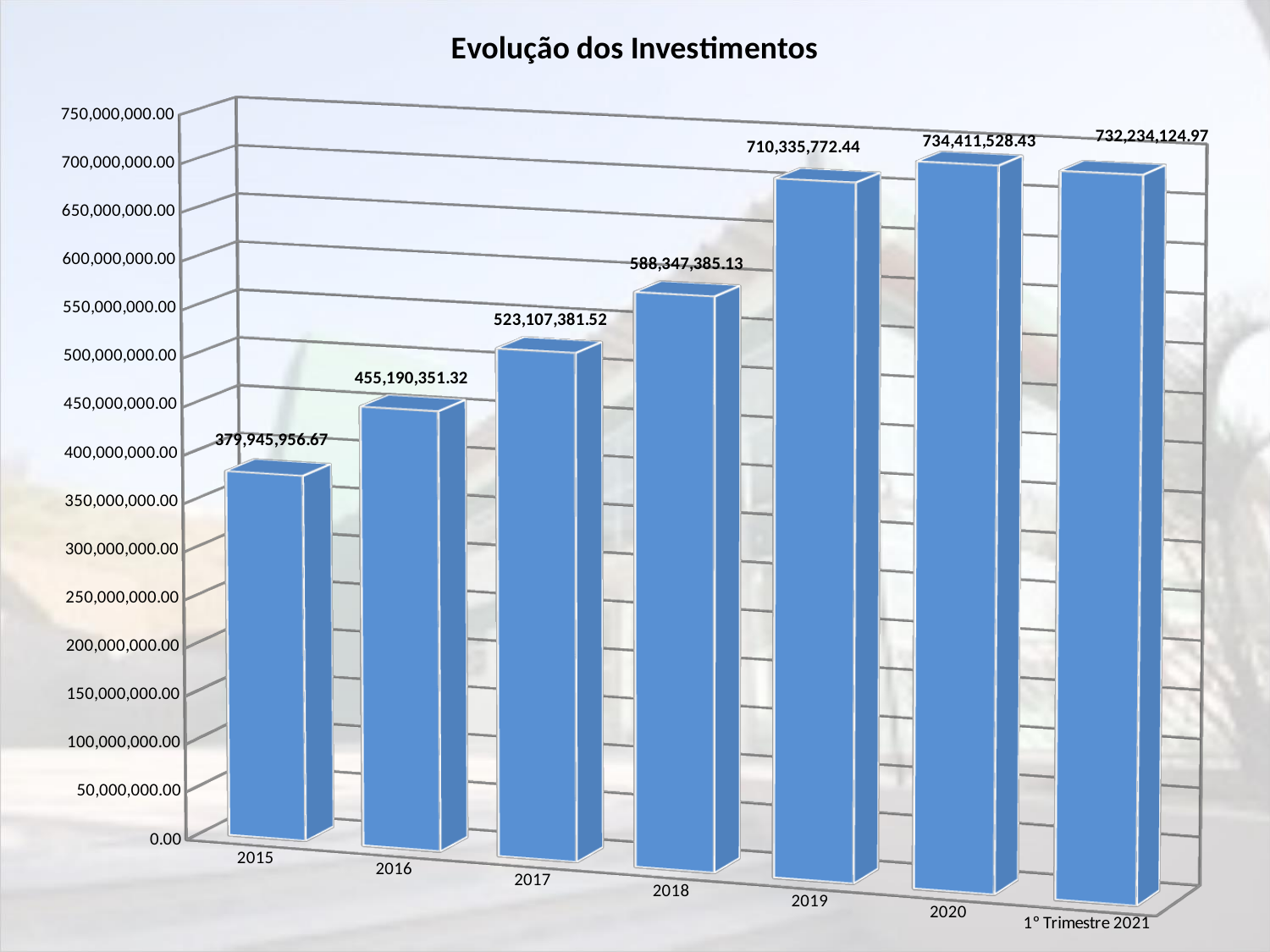
Is the value for 2017 greater or less than 500,000,000.00? greater What is the value for 1° Trimestre 2021? 732,234,124.97 What kind of chart is this? bar chart What is the value for 2015? 379,945,956.67 What is the value for 2018? 588,347,385.13 What is the difference between the values for 2020 and 2019? 24,075,755.99 How many categories are shown on the x axis? 7 Which category has the highest value? 2020 Which is larger, the value for 2020 or the value for 1° Trimestre 2021? 2020 What is the difference between the values for 2016 and 2015? 75,244,394.65 What is the title of the chart? Evolução dos Investimentos Which category has the lowest value? 2015